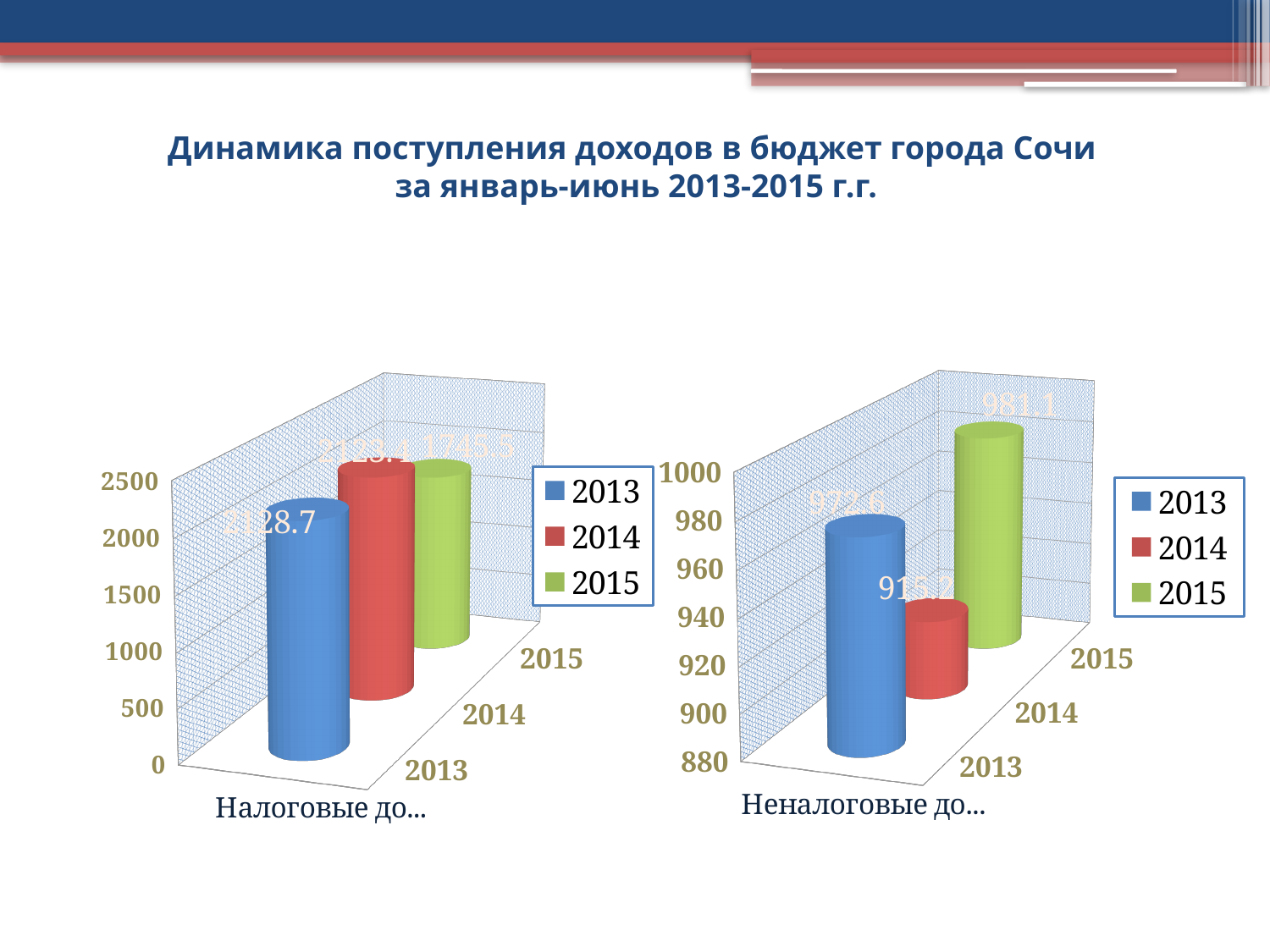
In the left chart, which year has the lowest value? 2015 In the right chart, what is the difference between the 2015 value and the 2014 value? 65.9 How many series does the legend of the left chart list? 3 In the right chart, what is the value for 2014? 915.2 In the right chart, which year has the lowest value? 2014 In the left chart, what is the difference between the 2013 value and the 2015 value? 383.2 In the left chart, what is the value for 2013? 2128.7 In the right chart, what is the value for 2015? 981.1 In the right chart, what is the value for 2013? 972.6 In the left chart, what is the value for 2015? 1745.5 What kind of chart is the left chart on the slide? bar chart In the right chart, which year has the highest value? 2015